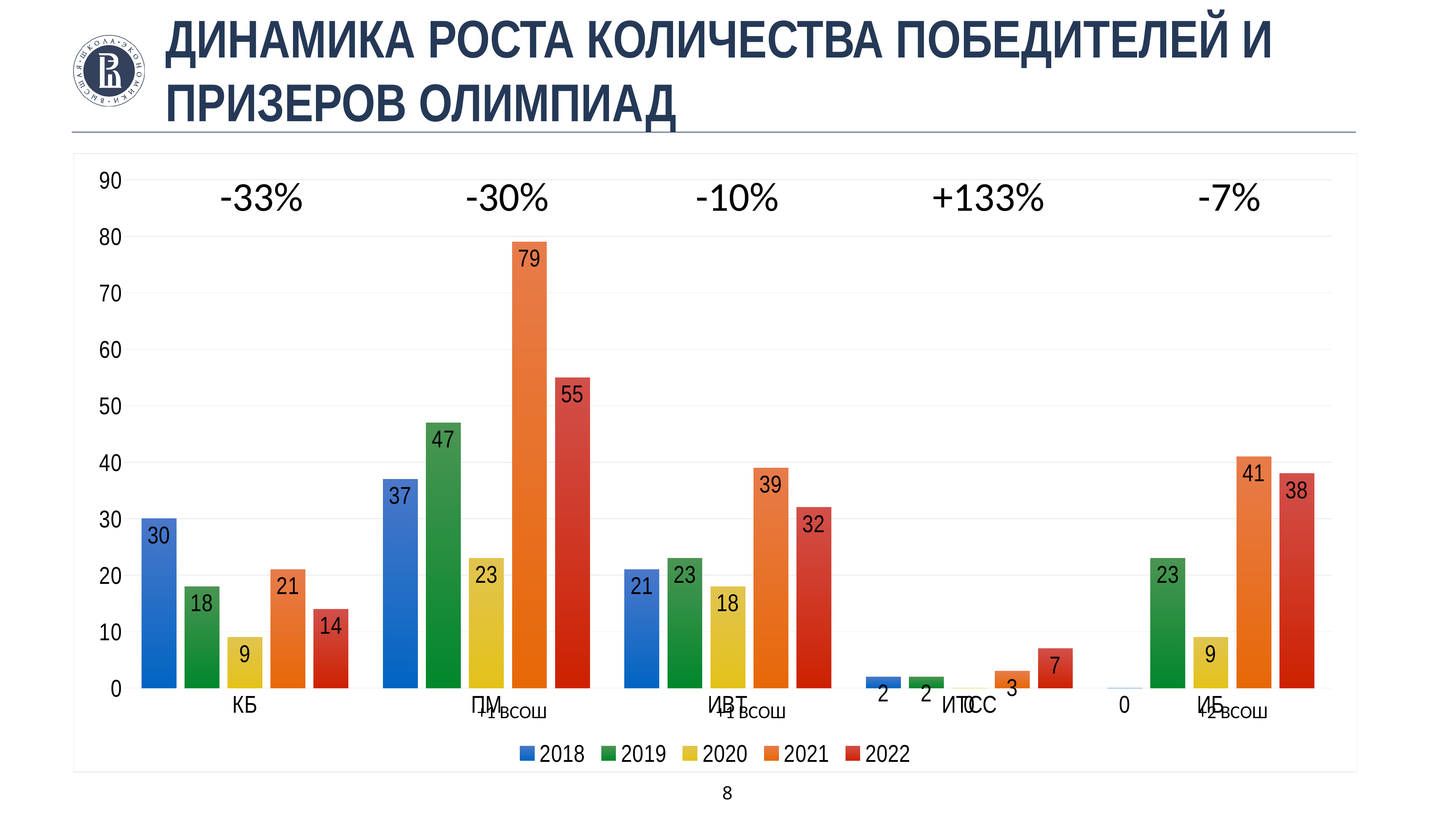
Which category has the highest value in 2021? ПМ What percentage change is printed above the ИТСС group? +133% Which is larger: the 2019 value for ПМ or the 2021 value for ИБ? 2019 value for ПМ How many categories are shown on the x axis? 5 What is the value for ИВТ in 2020? 18 What is the value for ПМ in 2021? 79 What kind of chart is shown on the slide? bar chart What is the value for КБ in 2018? 30 Which category has the lowest value in 2022? ИТСС What is the difference between the 2021 and 2022 values for ПМ? 24 What is the value for ИБ in 2022? 38 How many series does the legend list? 5